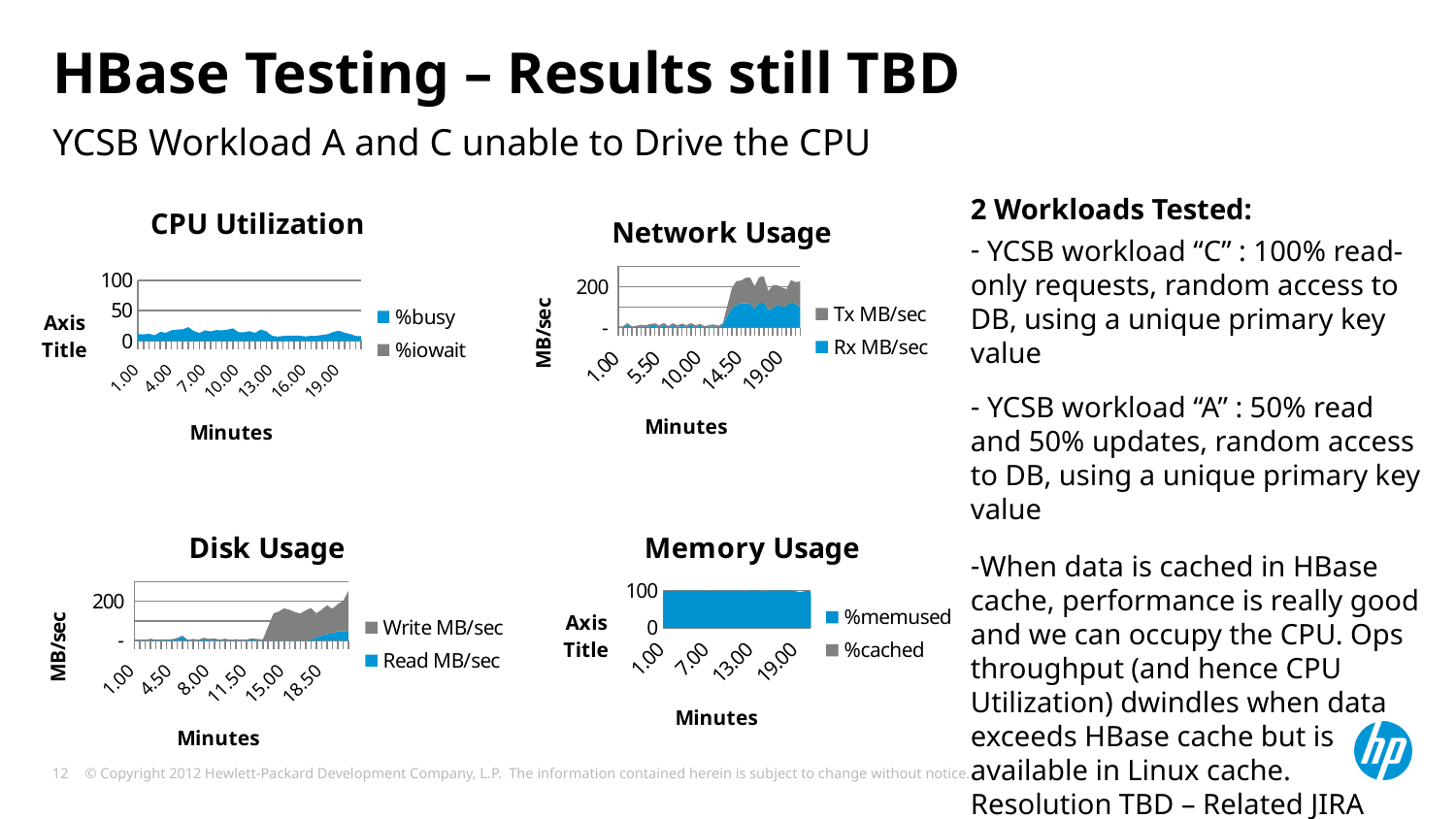
In the Network Usage chart, is the Rx MB/sec value at 5.50 minutes greater or less than 200? less In the Network Usage chart, do the values generally rise or fall from the start to the end of the x axis? rise How many series does the legend of the CPU Utilization chart list? 2 What is the y-axis title of the Disk Usage chart? MB/sec In the Disk Usage chart, is the Write MB/sec value at 4.50 minutes greater or less than 200? less In the CPU Utilization chart, is the %busy value at 10.00 minutes greater or less than 50? less Which two series are listed in the legend of the Disk Usage chart? Write MB/sec and Read MB/sec How many series does the legend of the Memory Usage chart list? 2 What type of chart is the CPU Utilization chart? area chart What is the x-axis title of the Network Usage chart? Minutes